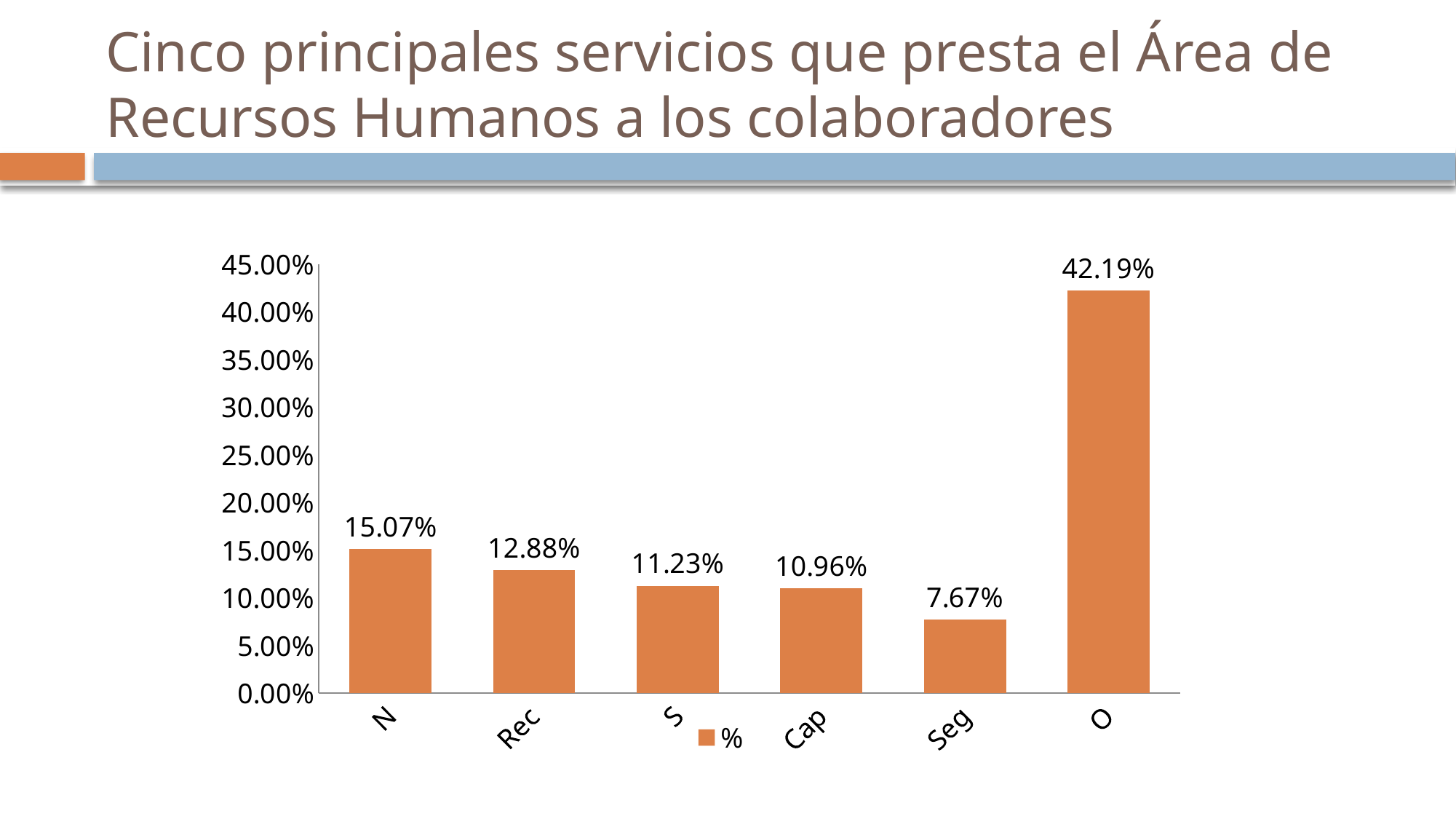
How many categories are shown on the x axis? 6 What is the legend entry shown below the chart? % What is the value for the category O? 42.19% What is the value for the category Rec? 12.88% Which category has the highest value? O What is the value for the category Seg? 7.67% Which category has the lowest value? Seg What is the difference between the values for S and Cap? 0.27% What kind of chart is shown on the slide? Bar chart What is the difference between the values for O and N? 27.12% Which is larger, the value for Rec or the value for Seg? Rec What is the value for the category N? 15.07%